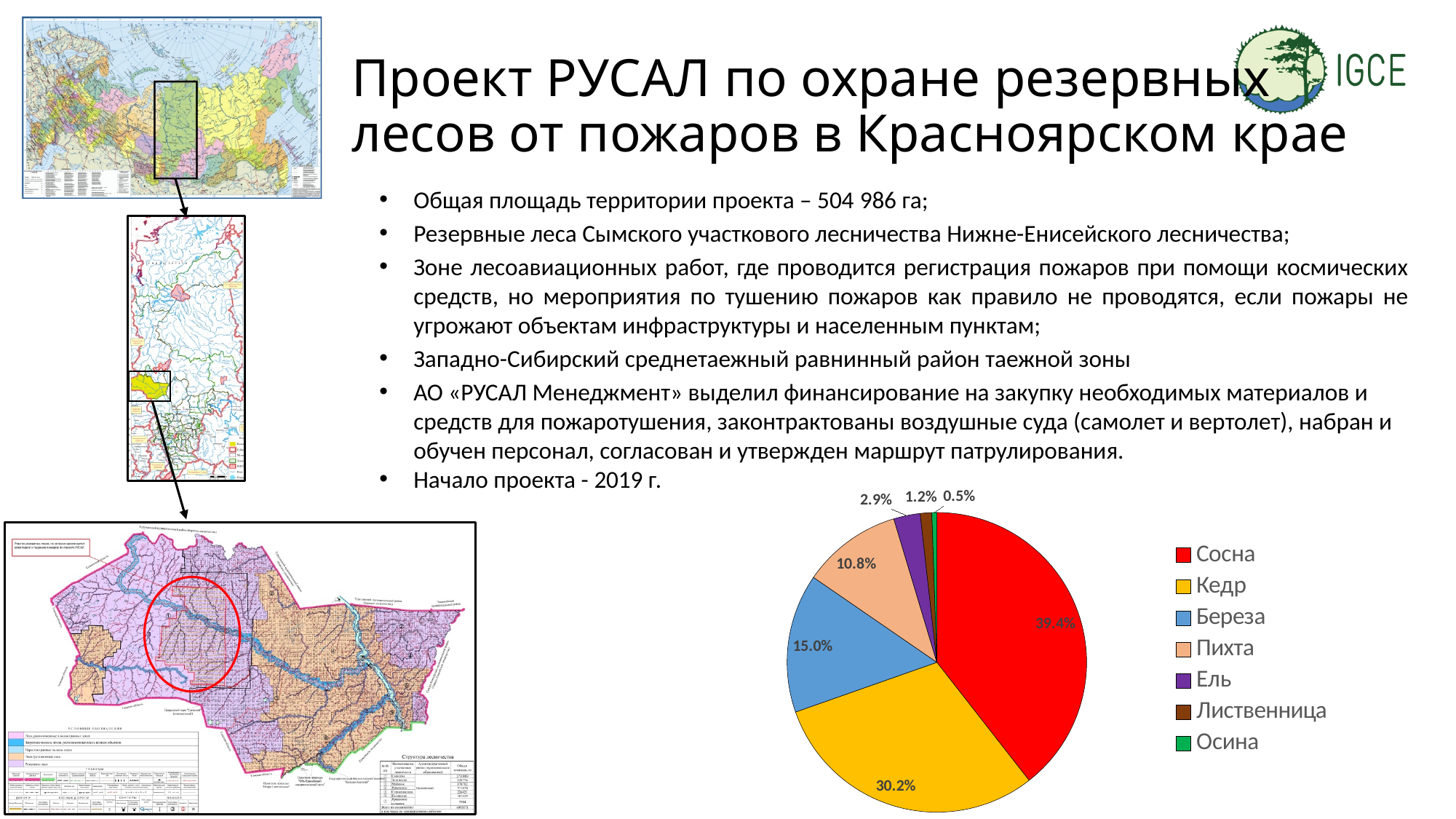
What share of the pie chart does Сосна have? 39.4% What share of the pie chart does Кедр have? 30.2% What share of the pie chart does Ель have? 2.9% Which has a larger share in the pie chart, Береза or Пихта? Береза How many categories does the pie chart legend list? 7 What is the difference between the shares of Сосна and Кедр in the pie chart? 9.2% Which category has the smallest slice in the pie chart? Осина What kind of chart is shown on the slide? pie chart Which category has the largest slice in the pie chart? Сосна What share of the pie chart does Пихта have? 10.8% What share of the pie chart does Береза have? 15.0% What colour is the Сосна slice in the pie chart? red